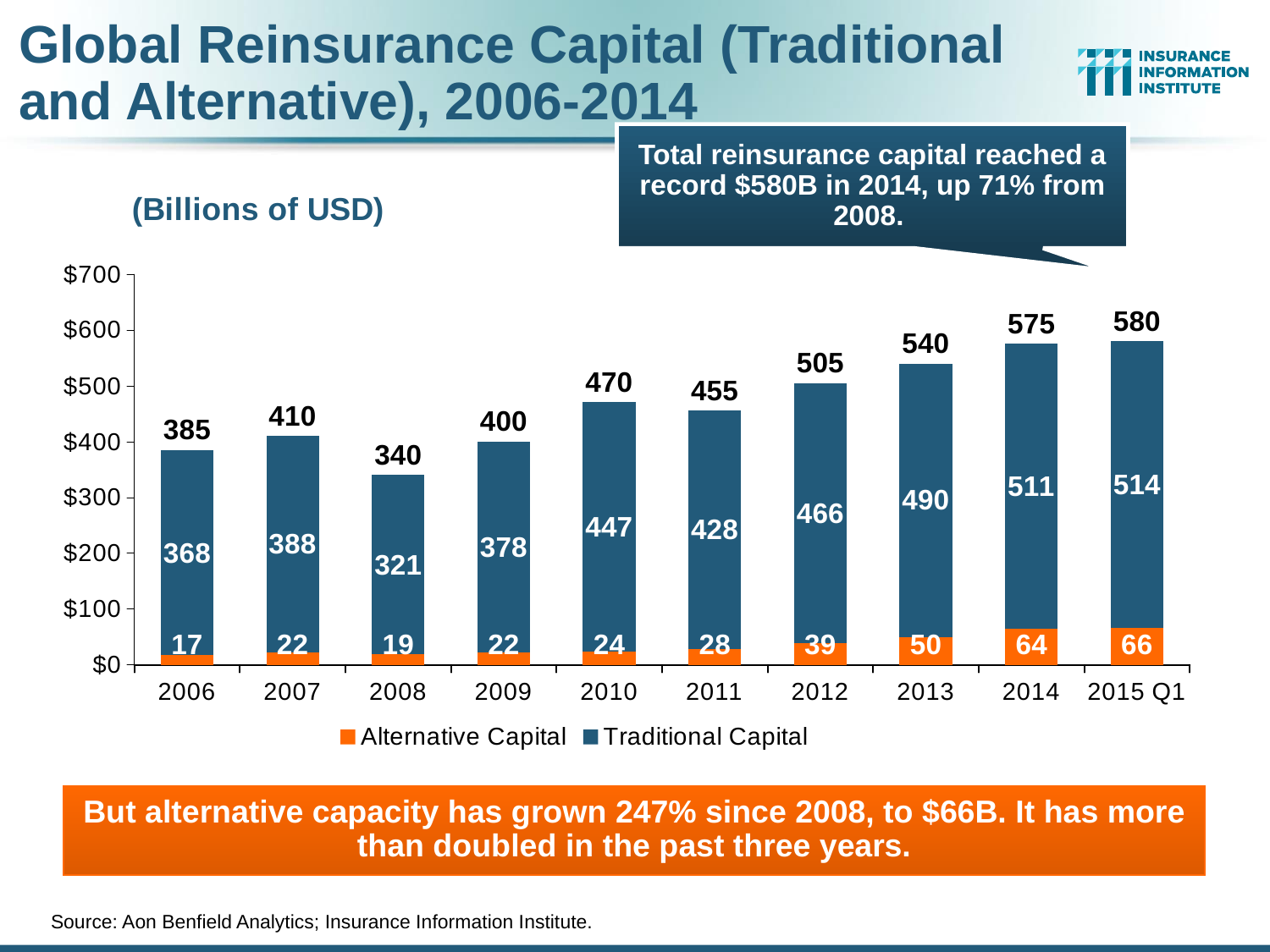
How many series does the legend list? 2 Which colour represents Alternative Capital in the chart? Orange Which period has the highest Alternative Capital value? 2015 Q1 Which is larger, the Traditional Capital value for 2011 or for 2012? 2012 What is the Traditional Capital value for 2010? 447 What is the total reinsurance capital shown for 2008? 340 Is the total for 2009 greater or less than $500? less What kind of chart is shown on the slide? Stacked bar chart What is the difference between the Alternative Capital values for 2014 and 2008? 45 What is the Alternative Capital value for 2013? 50 How many periods are shown on the x axis? 10 Which year has the lowest total reinsurance capital? 2008